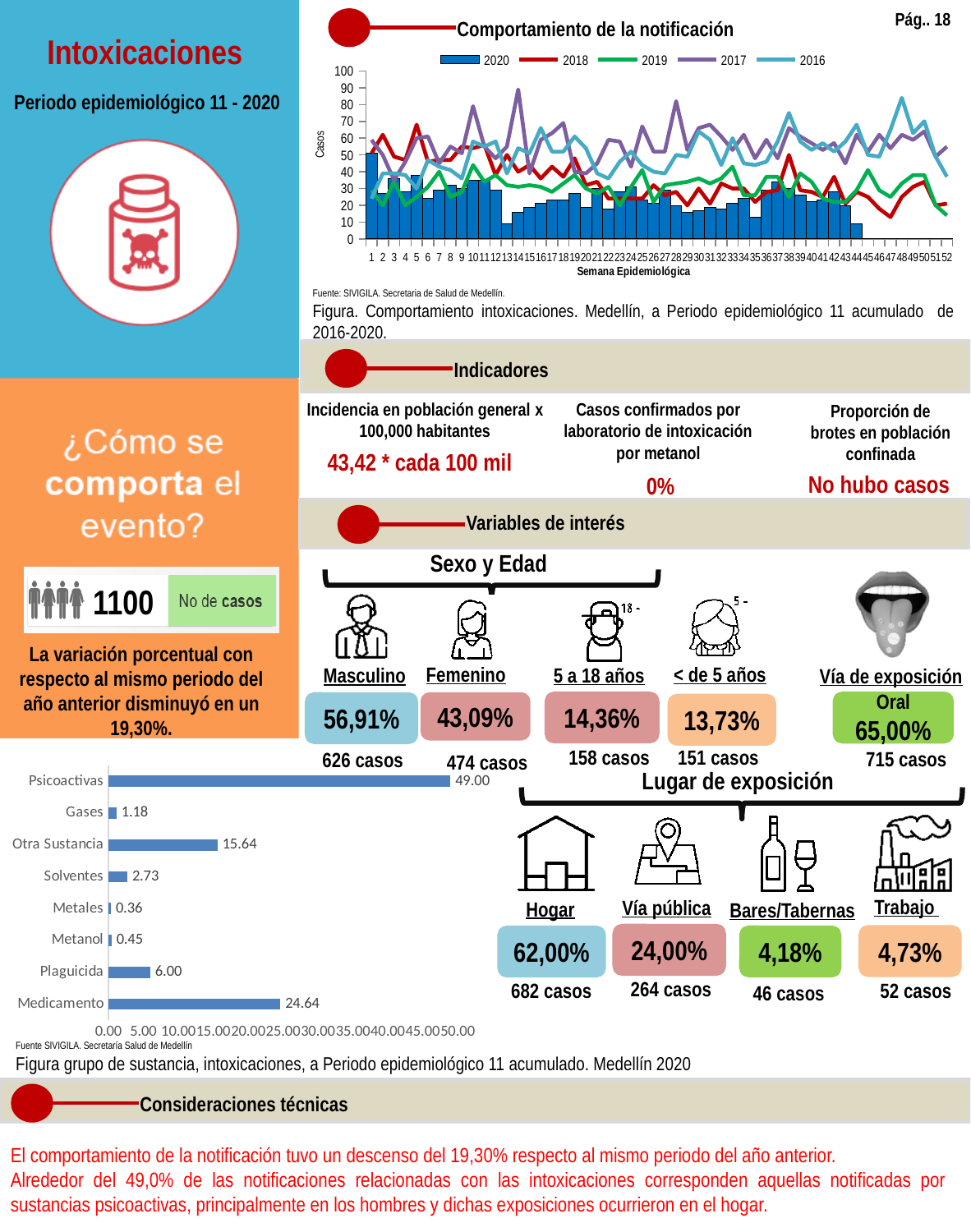
In the bottom-left bar chart of substance groups, what is the value for Psicoactivas? 49.00 In the bottom-left bar chart of substance groups, which is larger, Otra Sustancia or Plaguicida? Otra Sustancia How many series does the legend list in the chart titled 'Comportamiento de la notificación'? 5 How many categories are shown in the bottom-left bar chart of substance groups? 8 In the chart titled 'Comportamiento de la notificación', is the value for 2020 at week 13 greater or less than 20? less In the bottom-left bar chart of substance groups, what is the difference between Psicoactivas and Medicamento? 24.36 In the bottom-left bar chart of substance groups, what is the value for Medicamento? 24.64 In the bottom-left bar chart of substance groups, which category has the lowest value? Metales What kind of chart is the bottom-left chart of substance groups? Bar chart In the bottom-left bar chart of substance groups, what is the value for Plaguicida? 6.00 In the bottom-left bar chart of substance groups, which category has the highest value? Psicoactivas What is the x-axis label of the chart titled 'Comportamiento de la notificación'? Semana Epidemiológica